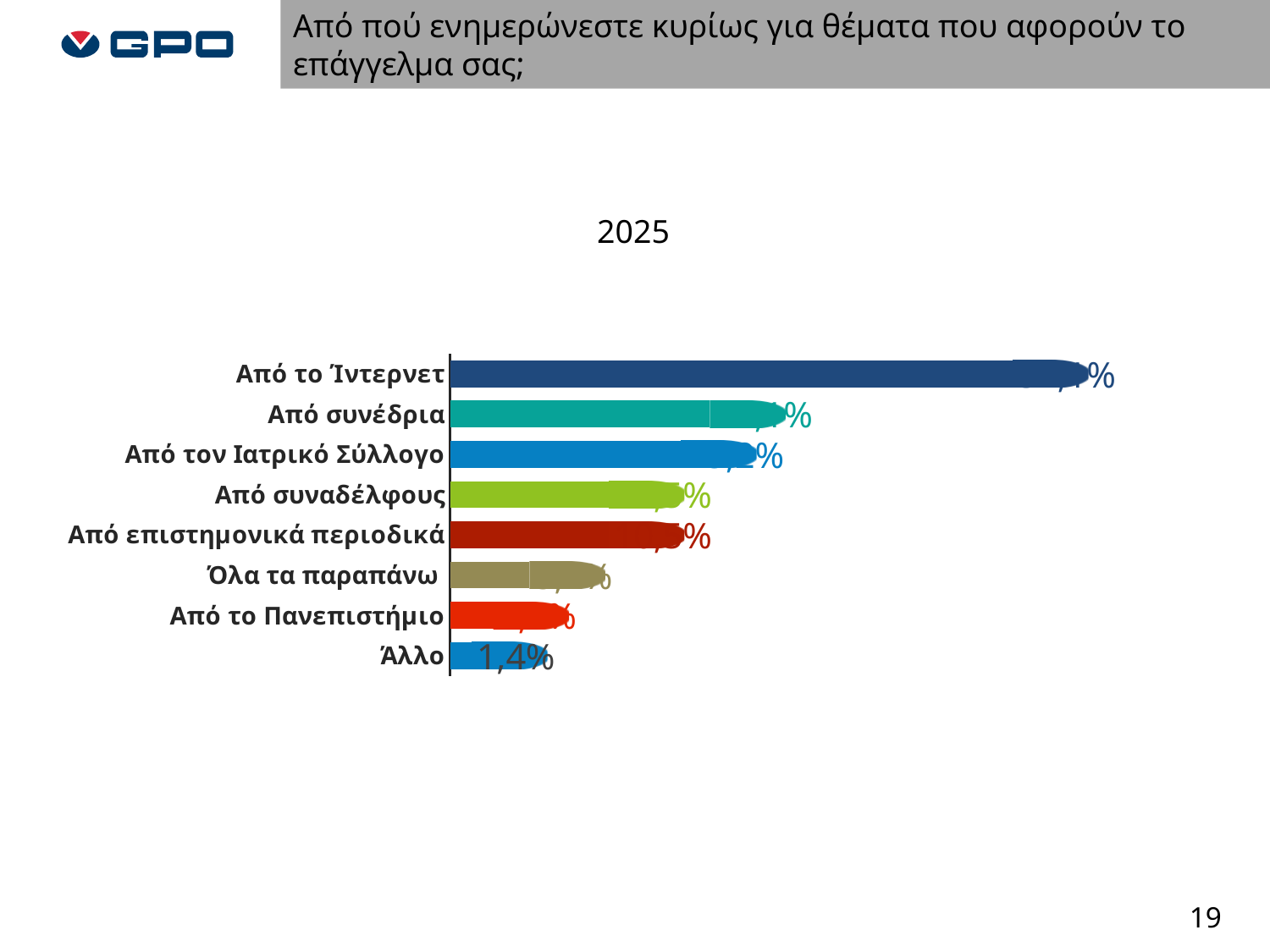
Which is larger: the value for Από συνέδρια or the value for Από συναδέλφους? Από συνέδρια Which is larger: the value for Από το Ίντερνετ or the value for Από συνέδρια? Από το Ίντερνετ Which is larger: the value for Από τον Ιατρικό Σύλλογο or the value for Από επιστημονικά περιοδικά? Από τον Ιατρικό Σύλλογο Which category has the lowest value in the chart? Άλλο How many categories does the bar chart show? 8 What is the value shown for Άλλο? 1,4% What year is shown as the title above the chart? 2025 Which category has the highest value in the chart? Από το Ίντερνετ Which category has the second-lowest value in the chart? Από το Πανεπιστήμιο What kind of chart is shown on the slide? bar chart